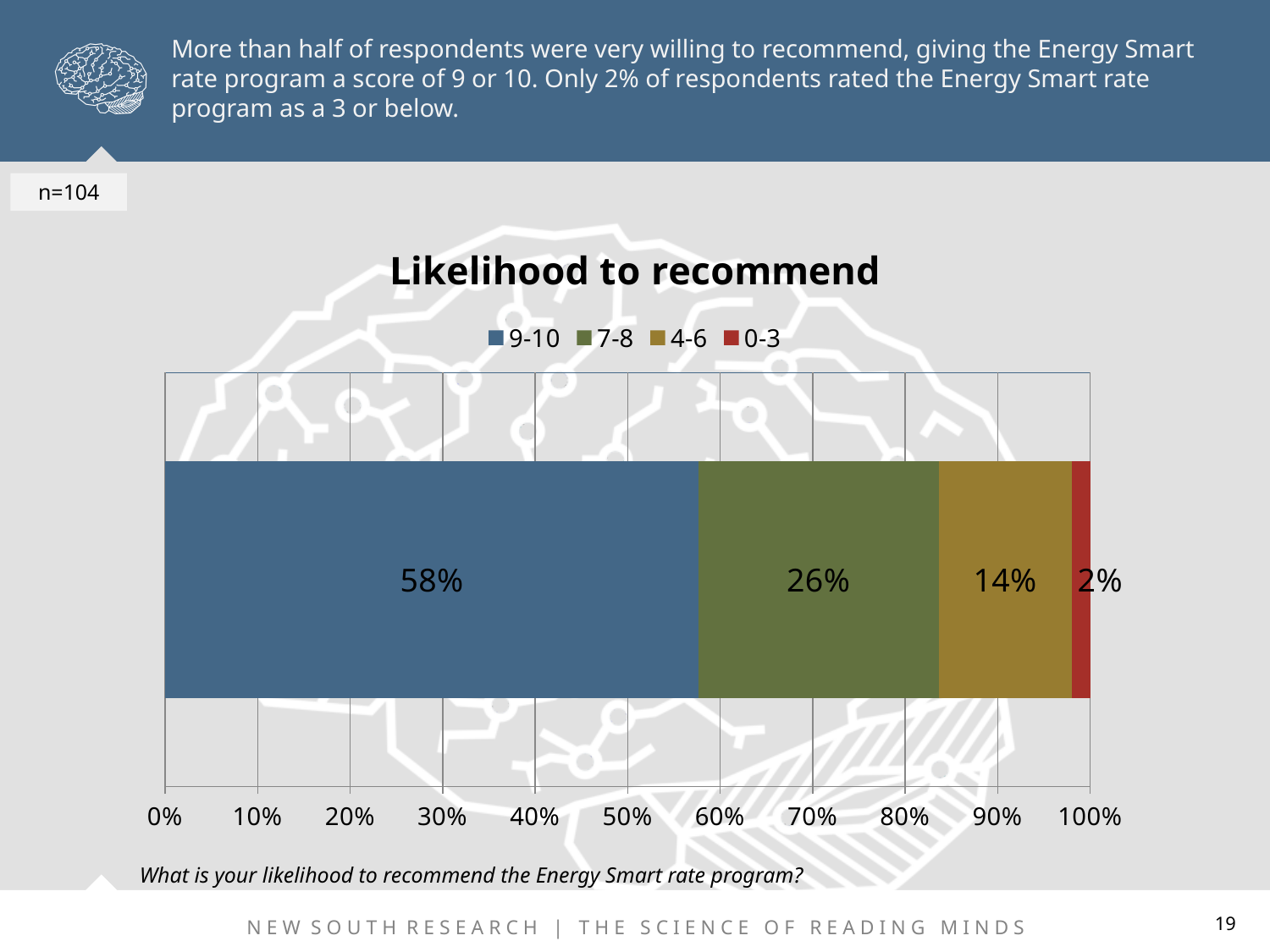
Which score group has the smallest share of respondents? 0-3 How many series does the legend list? 4 What is the total of all segments in the stacked bar? 100% What percentage of respondents gave a score of 4-6? 14% What is the title of the chart? Likelihood to recommend Which is larger, the share for 7-8 or the share for 4-6? 7-8 What kind of chart is shown on the slide? bar chart What percentage of respondents gave a score of 0-3? 2% Which score group has the largest share of respondents? 9-10 What percentage of respondents gave a score of 7-8? 26% What is the difference between the 9-10 share and the 7-8 share? 32% What percentage of respondents gave a score of 9-10? 58%